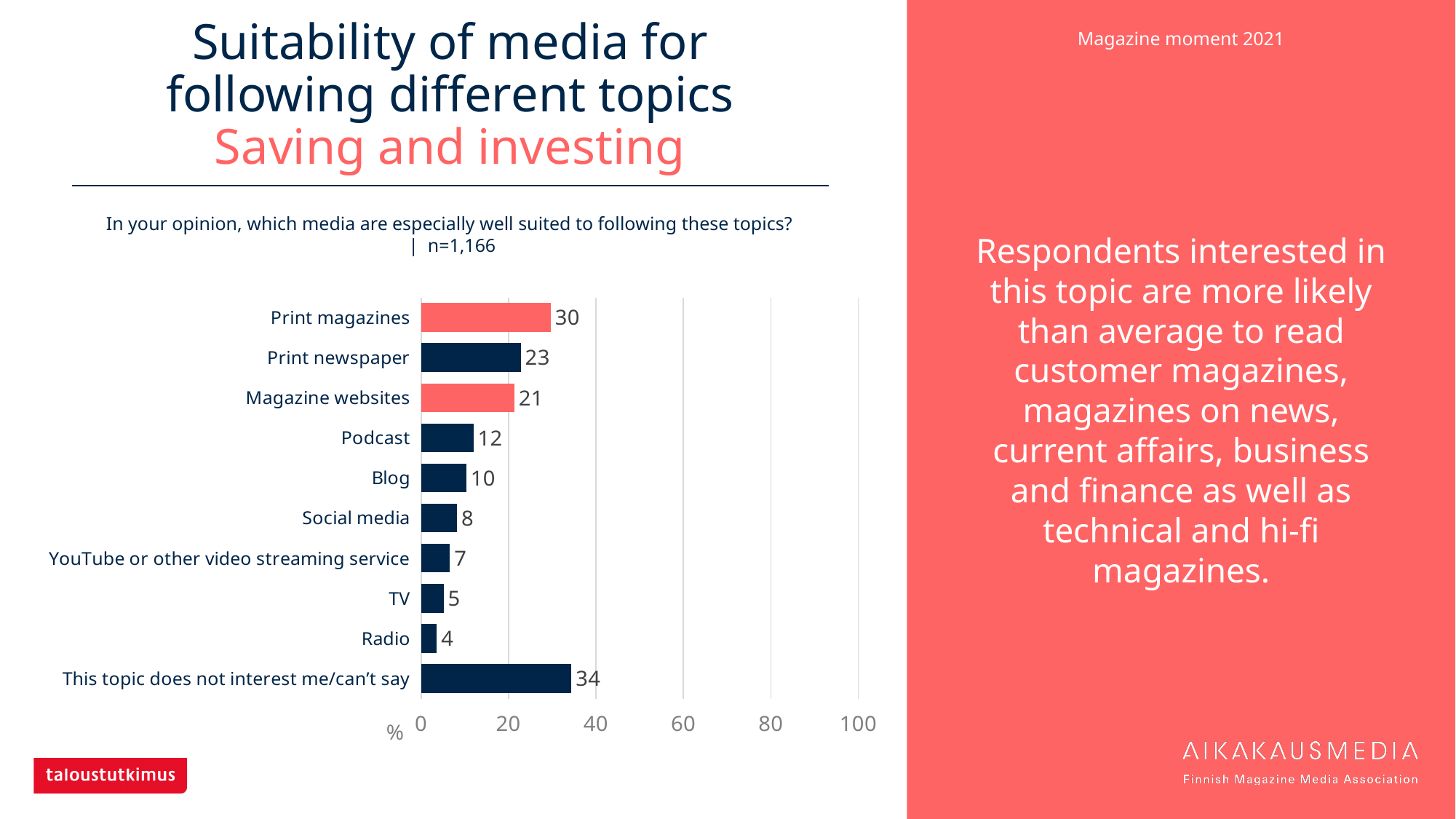
Is the value for Print newspaper greater or less than 20? greater What kind of chart is shown on the slide? Bar chart How many categories are shown in the chart? 10 Which is larger, the value for Blog or the value for Social media? Blog What is the difference between the values for Print magazines and Print newspaper? 7 What is the value for Print magazines? 30 What is the sample size (n) stated above the chart? n=1,166 Which category has the highest value? This topic does not interest me/can't say What is the value for Magazine websites? 21 What is the value for Radio? 4 What is the value for Podcast? 12 Which category has the lowest value? Radio